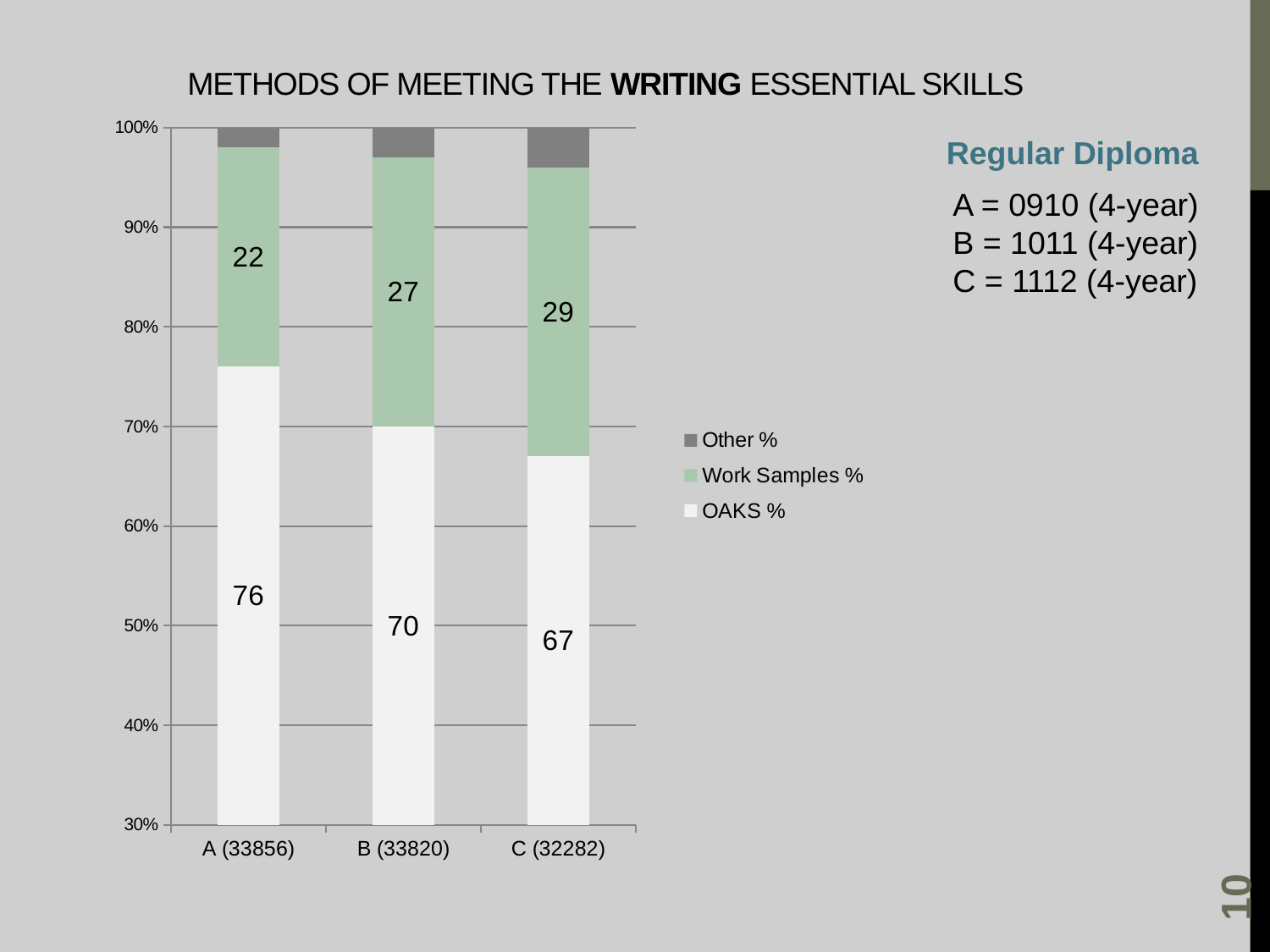
What is the Work Samples % value for A (33856)? 22 Do the OAKS % values rise or fall from A (33856) to C (32282)? Fall What kind of chart is shown on the slide? Stacked bar chart How many categories are shown on the x axis? 3 Which is larger, the Work Samples % value for B (33820) or for C (32282)? C (32282) What is the OAKS % value for A (33856)? 76 How many series does the legend list? 3 What is the OAKS % value for B (33820)? 70 What is the Work Samples % value for C (32282)? 29 What is the difference between the OAKS % values for A (33856) and C (32282)? 9 Which category has the highest OAKS % value? A (33856) Which category has the lowest Work Samples % value? A (33856)